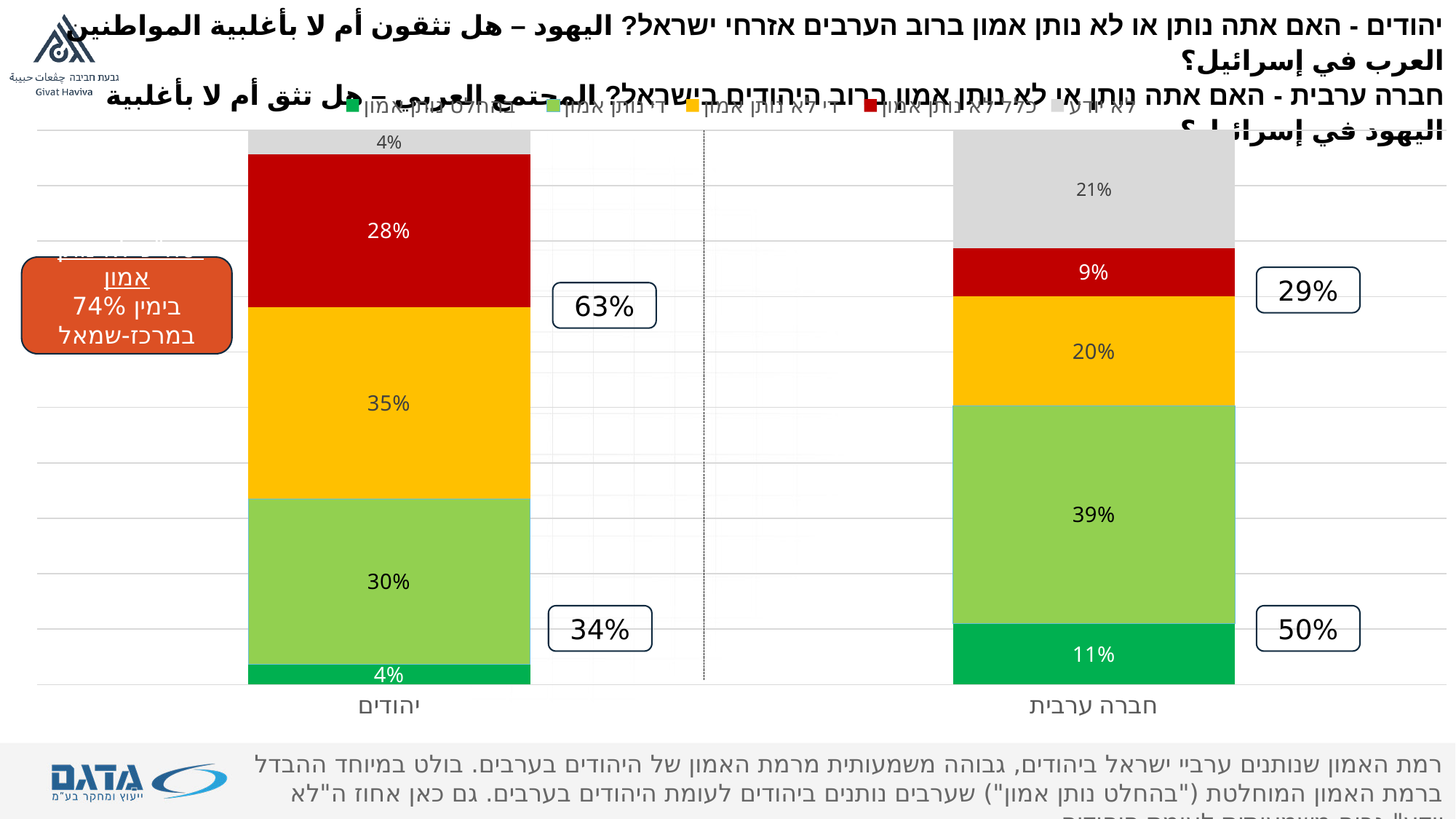
Which category has the larger gray (לא יודע) segment, יהודים or חברה ערבית? חברה ערבית Which segment is the largest in the יהודים bar? 35% (די לא נותן אמון, yellow) What is the value of the light green segment (די נותן אמון) for חברה ערבית? 39% What type of chart is shown on the slide? stacked bar chart What is the value of the red segment (כלל לא נותן אמון) for יהודים? 28% What is the difference between the red segment values for יהודים (28%) and חברה ערבית (9%)? 19% What is the combined value of the yellow and red segments (20% and 9%) for חברה ערבית, as shown in the callout? 29% What is the value of the gray segment (לא יודע) for יהודים? 4% What is the value of the yellow segment (די לא נותן אמון) for חברה ערבית? 20% What is the combined value of the two green segments (4% and 30%) for יהודים, as shown in the callout? 34% What is the value of the dark green segment (בהחלט נותן אמון) for חברה ערבית? 11% How many categories are shown on the x axis of the chart? 2